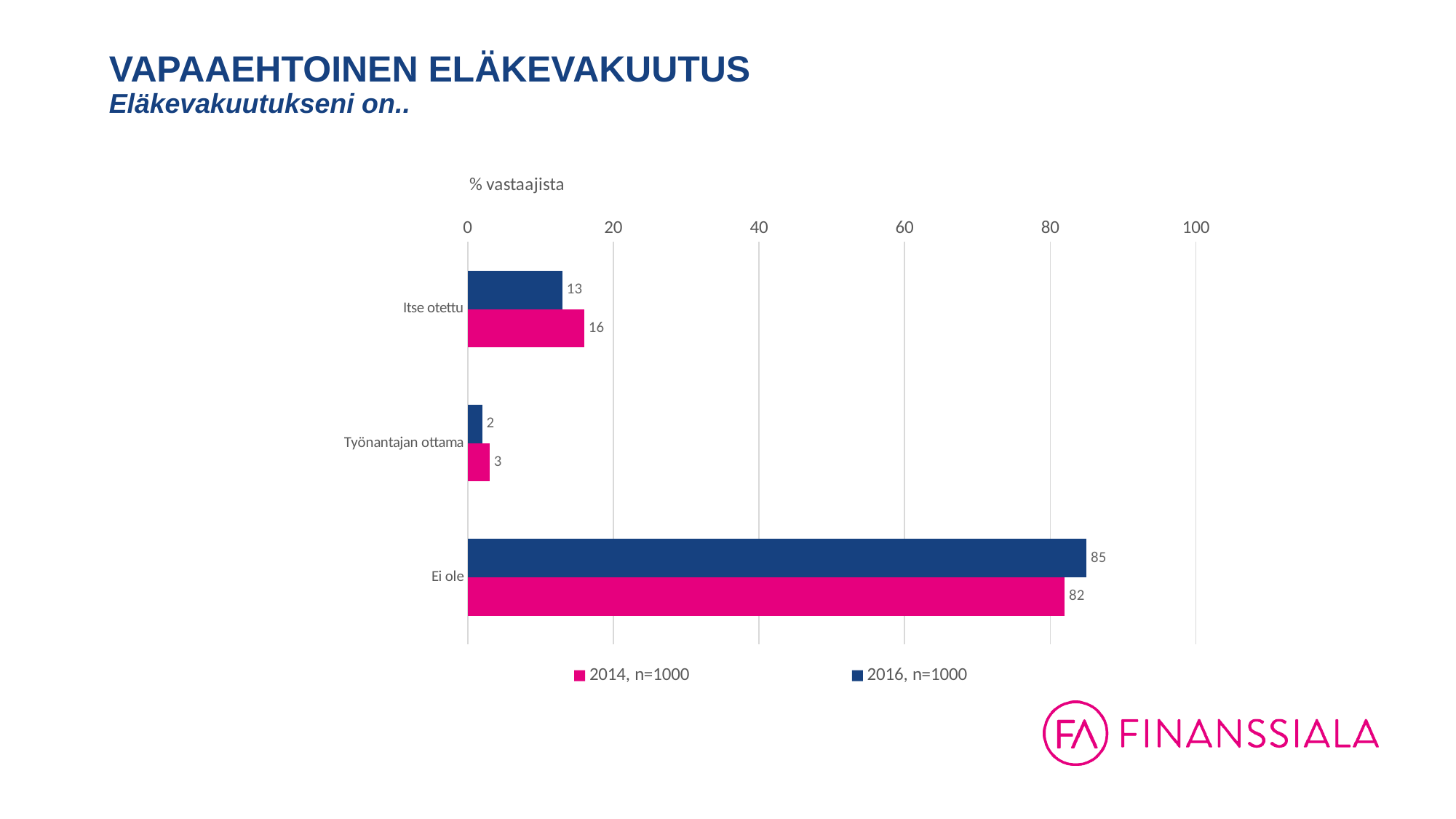
For "Itse otettu", which series has the larger value, 2014, n=1000 or 2016, n=1000? 2014, n=1000 Is the 2014 value for "Ei ole" greater or less than 80? greater What is the difference between the 2014 and 2016 values for "Itse otettu"? 3 How many categories are shown on the chart? 3 What is the difference between the 2016 and 2014 values for "Ei ole"? 3 What is the value for "Itse otettu" in the 2014, n=1000 series? 16 What kind of chart is shown on the slide? Bar chart What is the value for "Työnantajan ottama" in the 2016, n=1000 series? 2 Which category has the lowest value in the 2016, n=1000 series? Työnantajan ottama Which category has the highest value in the 2014, n=1000 series? Ei ole What is the value for "Ei ole" in the 2016, n=1000 series? 85 How many series does the legend list? 2